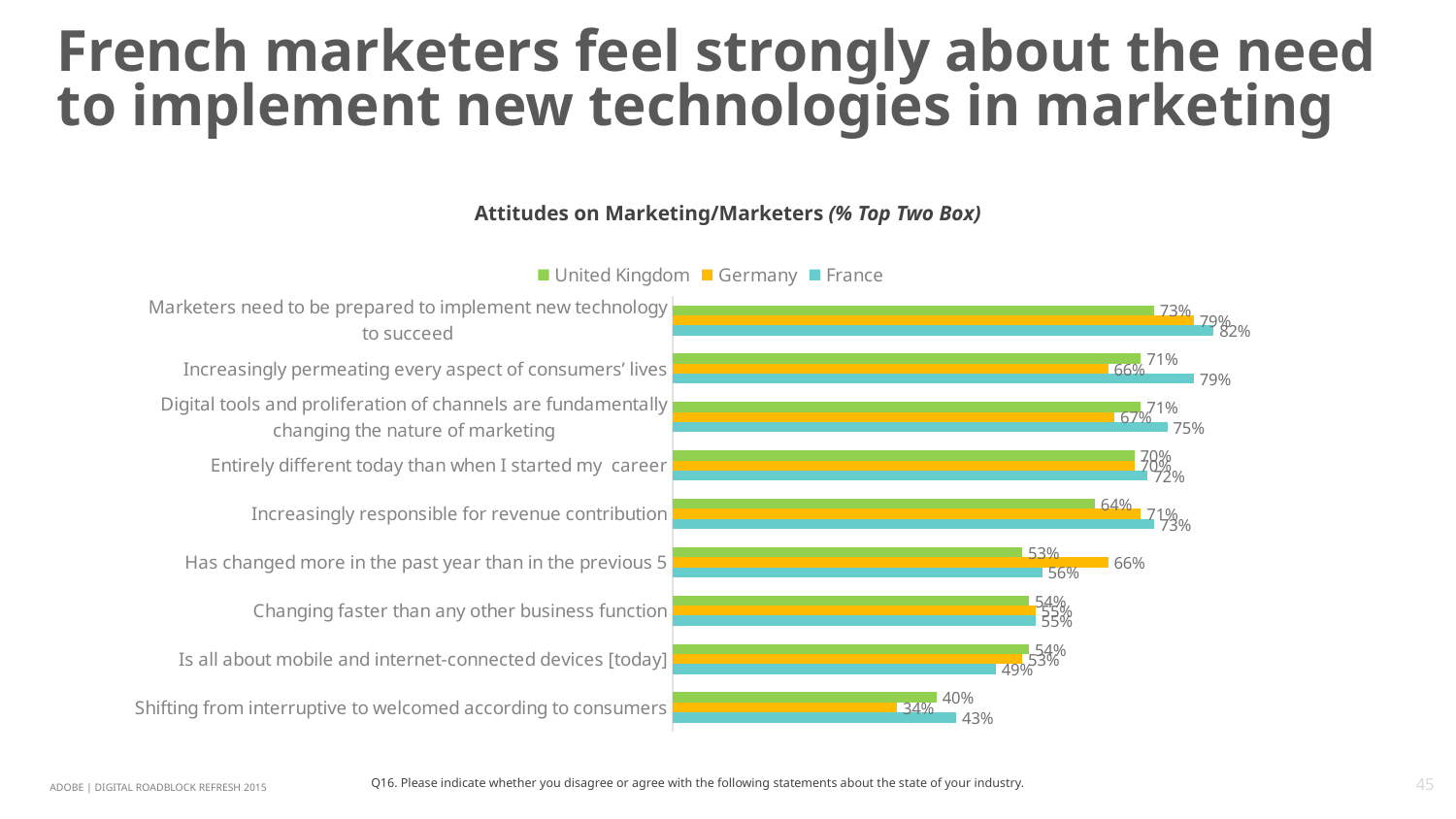
What is the value for France for "Increasingly responsible for revenue contribution"? 73% How many series does the legend list? 3 What is the difference between the France and United Kingdom values for "Marketers need to be prepared to implement new technology to succeed"? 9 percentage points What is the value for the United Kingdom for "Shifting from interruptive to welcomed according to consumers"? 40% For which statement is the France value the lowest? Shifting from interruptive to welcomed according to consumers What is the value for Germany for "Has changed more in the past year than in the previous 5"? 66% Which country has the highest value for "Increasingly permeating every aspect of consumers' lives"? France How many statements (categories) are shown in the chart? 9 Which is larger for "Has changed more in the past year than in the previous 5": Germany or France? Germany What kind of chart is shown on the slide? Bar chart What is the title of the chart? Attitudes on Marketing/Marketers (% Top Two Box) What is the value for France for "Marketers need to be prepared to implement new technology to succeed"? 82%